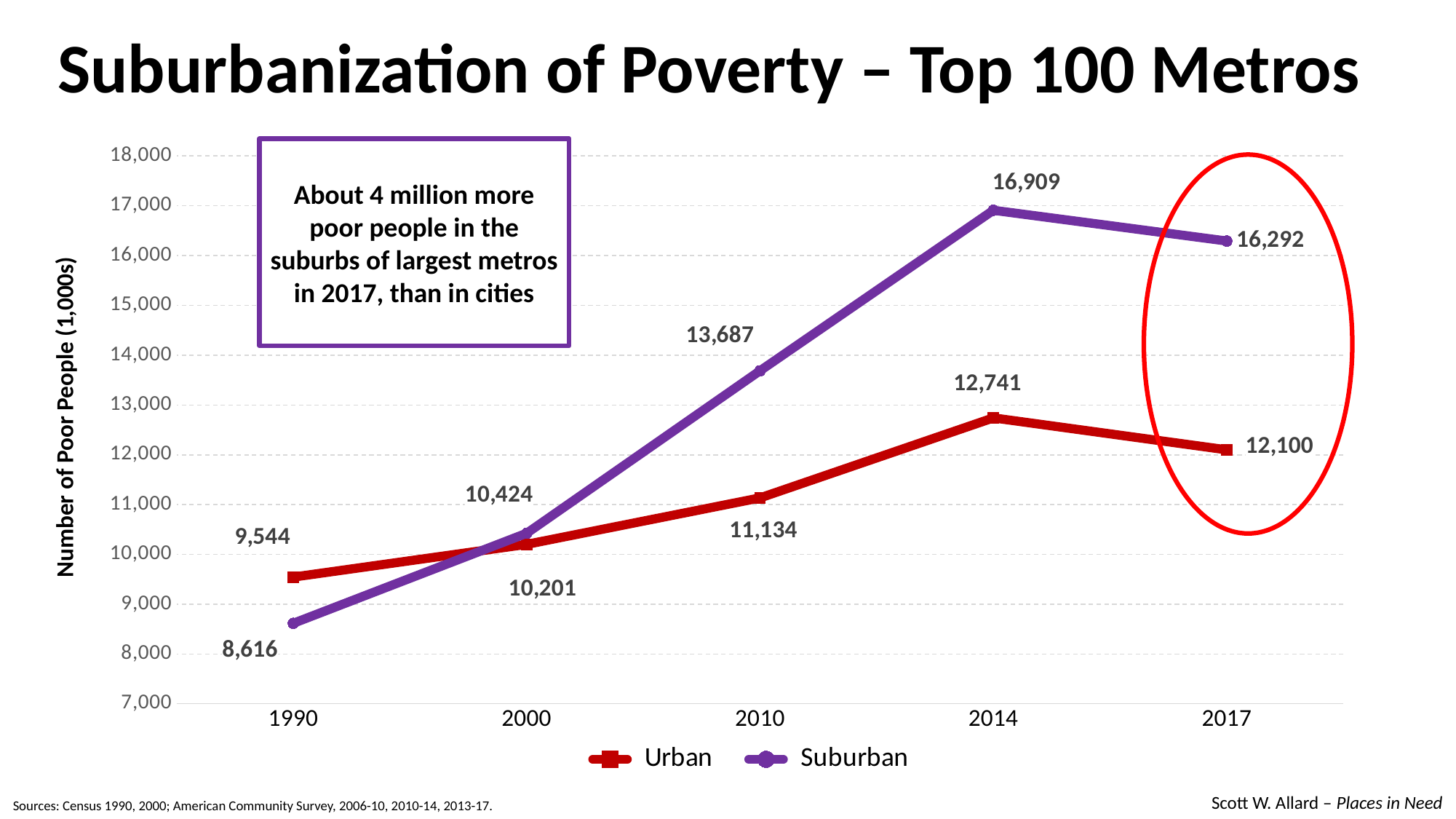
In 1990, which series has the larger value, Urban or Suburban? Urban What is the difference between the Suburban and Urban values in 2017? 4,192 What is the Urban value in 1990? 9,544 In which year is the Suburban series at its lowest value? 1990 In which year does the Suburban series reach its highest value? 2014 How many years are shown on the x axis? 5 What is the Urban value in 2014? 12,741 What is the Suburban value in 2017? 16,292 What is the Suburban value in 2010? 13,687 How many series does the legend list? 2 What kind of chart is shown on the slide? line chart Is the Urban value in 2010 greater or less than 12,000? less